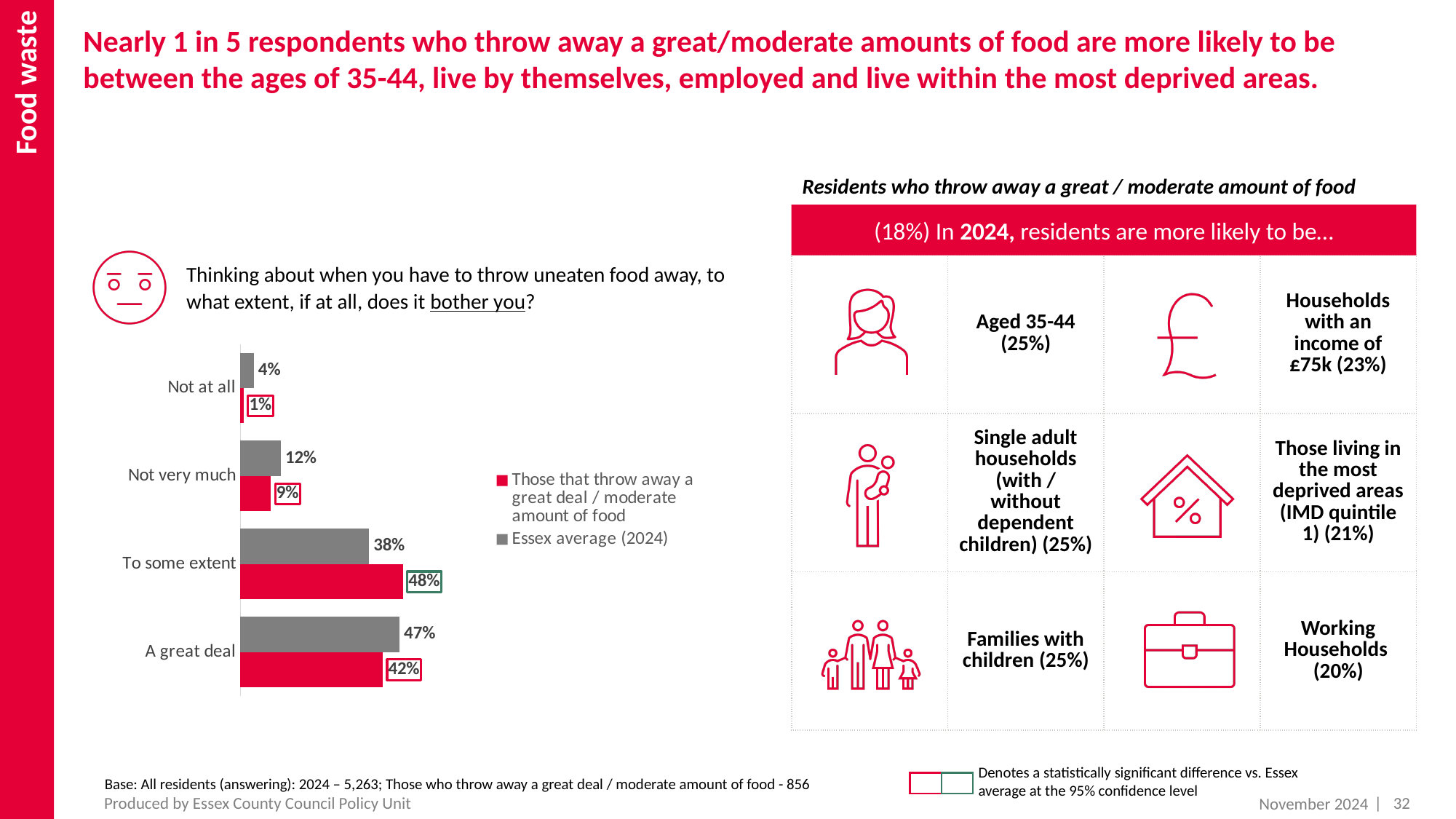
What is the Essex average (2024) value for 'Not very much'? 12% How many response categories are shown in the bar chart? 4 What is the difference between the Essex average (2024) and those that throw away a great deal / moderate amount of food for 'To some extent'? 10 percentage points How many series does the chart legend list? 2 Which colour represents the Essex average (2024) series in the chart? Grey What type of chart is used to show how much throwing away uneaten food bothers respondents? Bar chart Which category has the lowest Essex average (2024) value? Not at all What is the value for 'Not at all' among those that throw away a great deal / moderate amount of food? 1% What percentage of those that throw away a great deal / moderate amount of food answered 'A great deal'? 42% Which category has the highest value for those that throw away a great deal / moderate amount of food? To some extent For 'A great deal', which is larger: the Essex average (2024) or those that throw away a great deal / moderate amount of food? Essex average (2024) What is the Essex average (2024) value for 'To some extent'? 38%